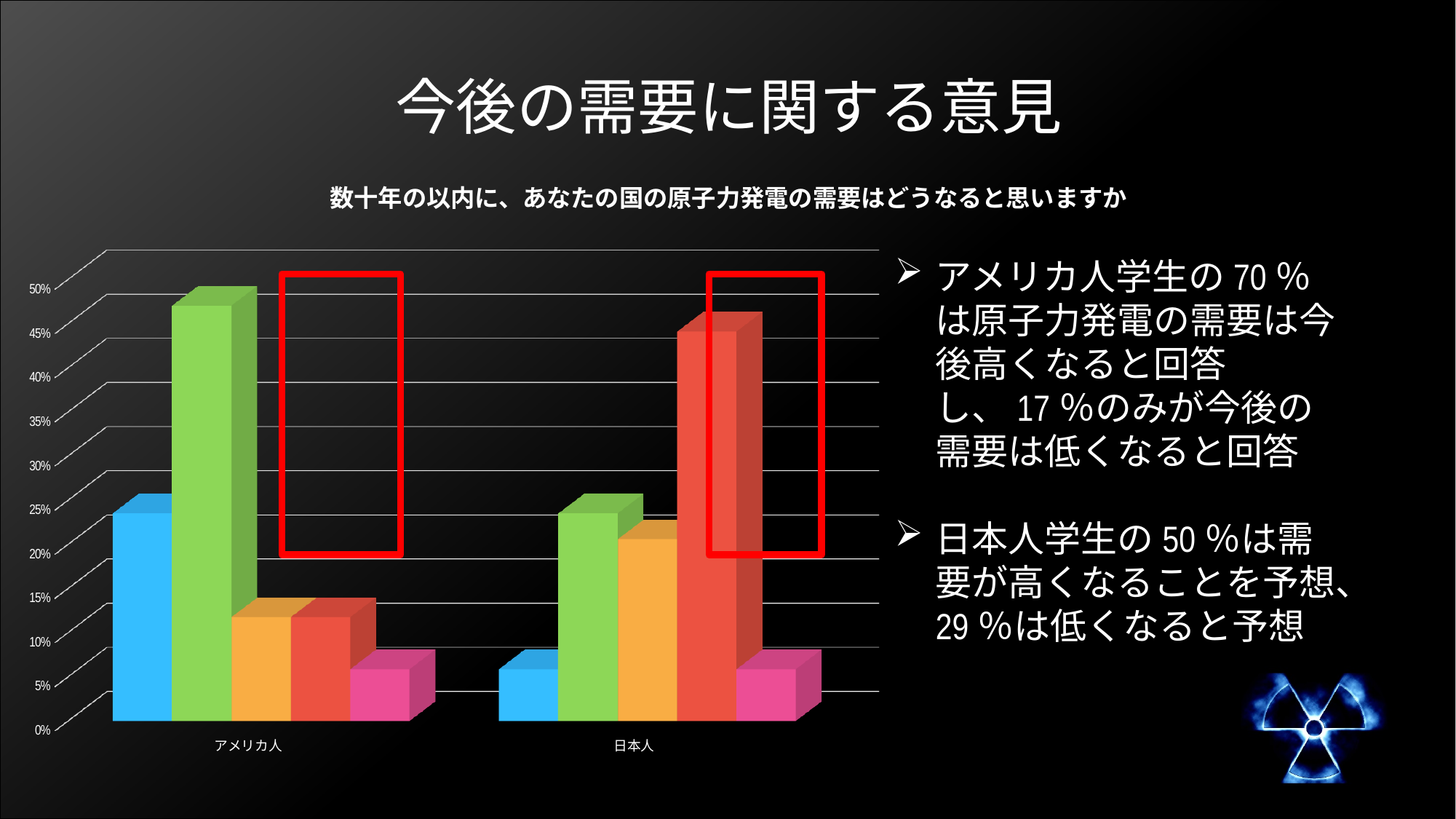
Which is larger, the green bar for アメリカ人 or the green bar for 日本人? the green bar for アメリカ人 Which bar is the shortest in the アメリカ人 group? the pink bar How many categories are shown on the x axis of the chart? 2 Is the value of the red bar for 日本人 greater or less than 35%? greater Which bar is the tallest in the アメリカ人 group? the green bar Which bar is the tallest in the 日本人 group? the red bar Is the value of the blue bar for アメリカ人 greater or less than 15%? greater What kind of chart is shown on the slide? bar chart Is the value of the green bar for アメリカ人 greater or less than 40%? greater What is the title of the chart? 数十年の以内に、あなたの国の原子力発電の需要はどうなると思いますか How many bars are plotted for the アメリカ人 category? 5